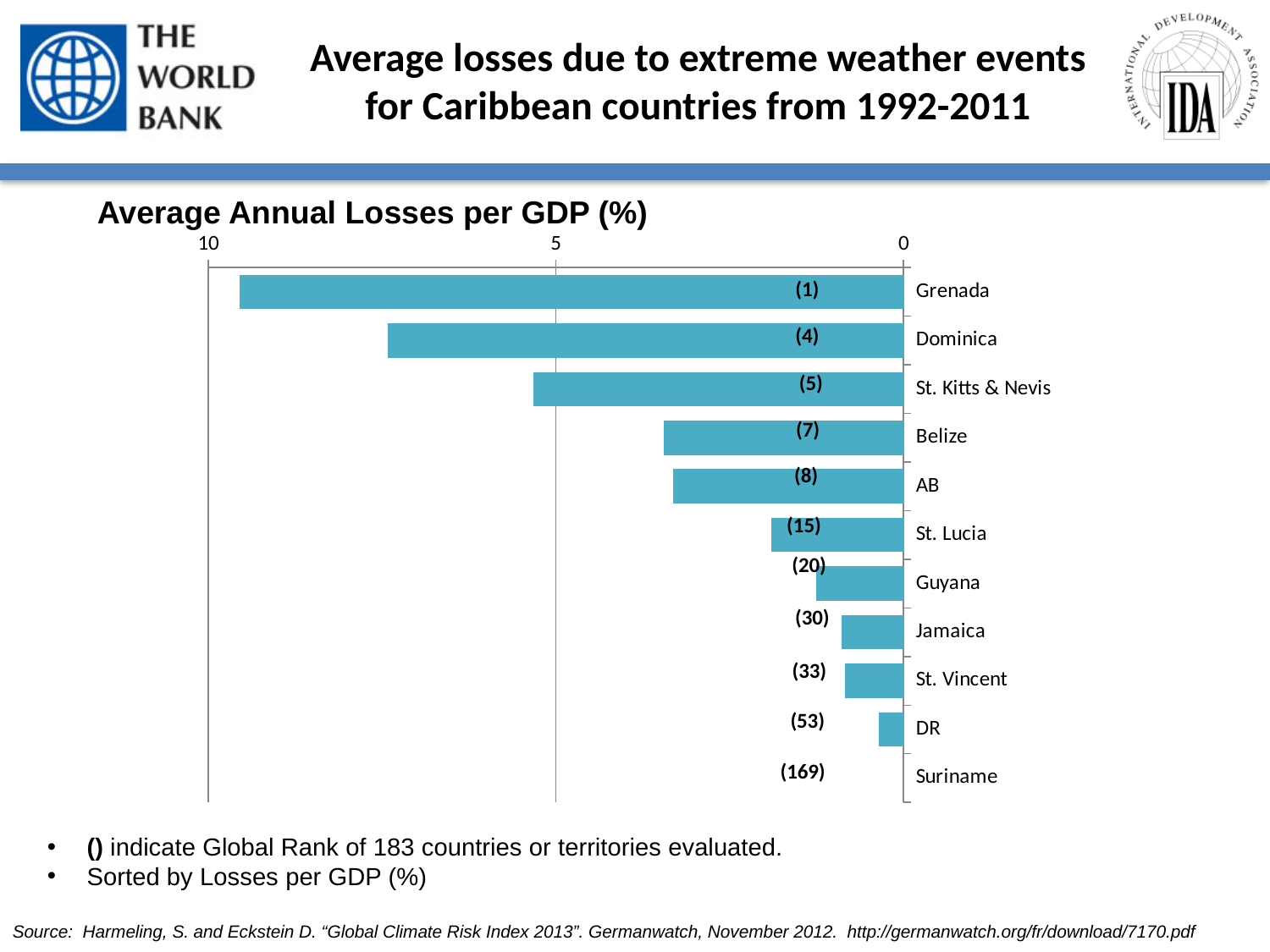
What is the title of the chart? Average Annual Losses per GDP (%) Which has higher average annual losses per GDP, St. Lucia or DR? St. Lucia Which country has the lowest average annual losses per GDP? Suriname What kind of chart is shown on the slide? bar chart Is the value for Dominica greater or less than 5? greater Is the value for Grenada greater or less than 5? greater What global rank is shown in parentheses for Suriname? (169) Is the value for Belize greater or less than 5? less Which country has the highest average annual losses per GDP? Grenada Which has higher average annual losses per GDP, Dominica or Belize? Dominica How many countries are shown in the chart? 11